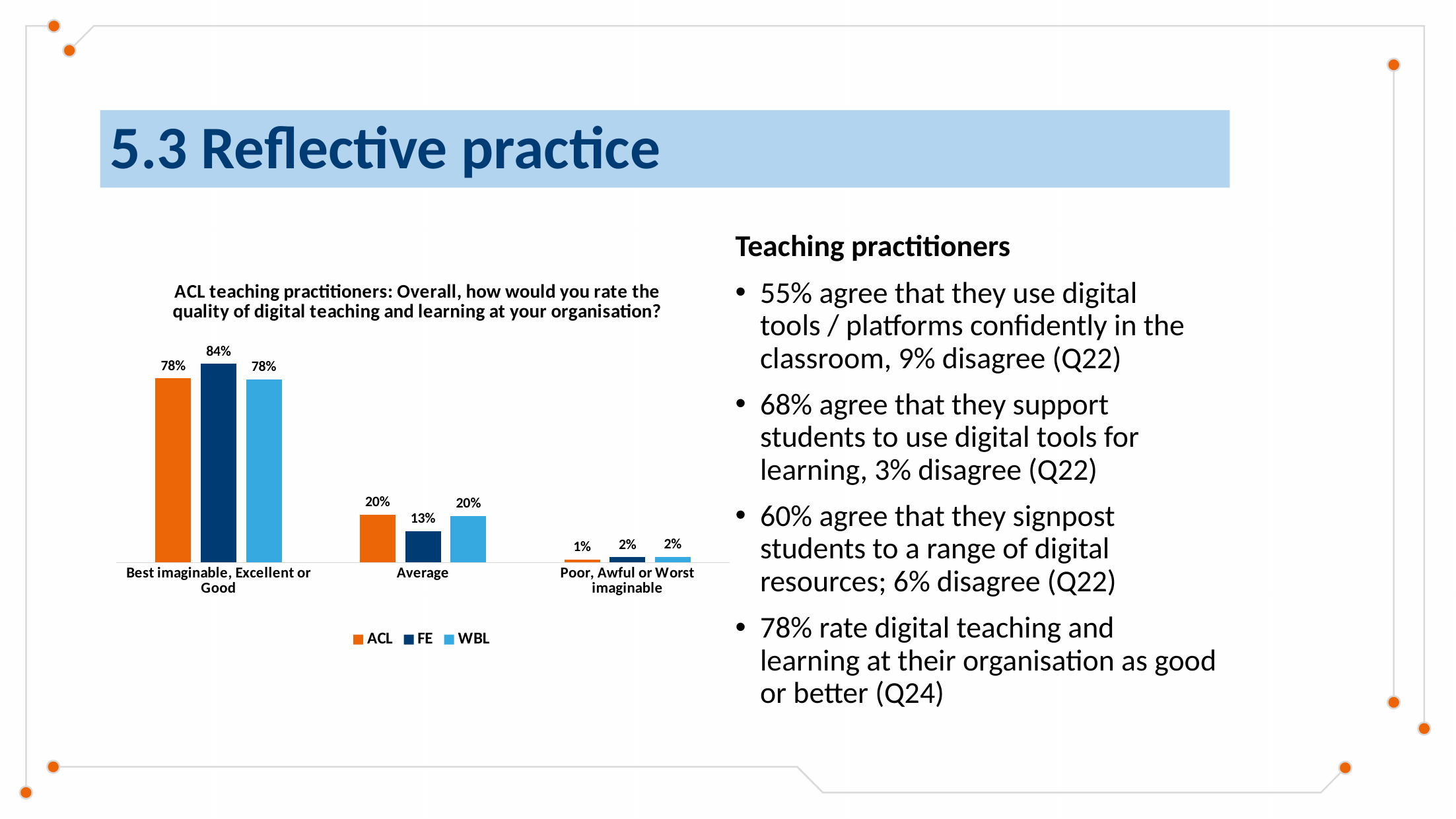
Which is larger for ACL: 'Best imaginable, Excellent or Good' or 'Average'? Best imaginable, Excellent or Good What is the ACL value for 'Average'? 20% What is the FE value for 'Best imaginable, Excellent or Good'? 84% What is the WBL value for 'Poor, Awful or Worst imaginable'? 2% Which series has the highest value for 'Best imaginable, Excellent or Good'? FE How many series does the legend list? 3 Which series has the lowest value for 'Average'? FE How many categories are shown on the x axis? 3 What is the FE value for 'Average'? 13% What is the difference between the ACL and FE values for 'Average'? 7% What is the difference between the FE and ACL values for 'Best imaginable, Excellent or Good'? 6% What kind of chart is shown on the slide? Bar chart